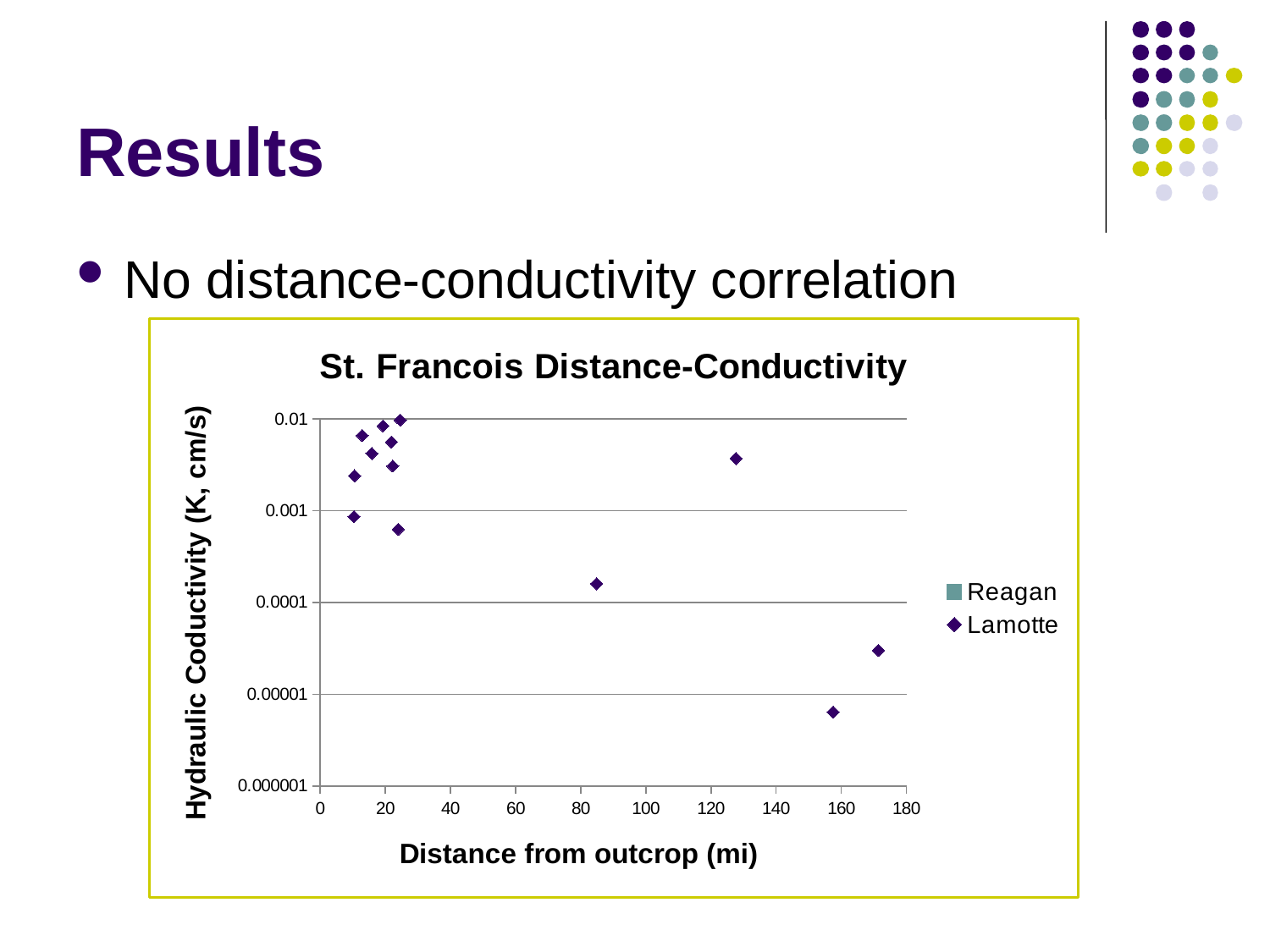
What kind of chart is shown on the slide? scatter chart Is the hydraulic conductivity of the point plotted near 85 mi greater or less than 0.001? less Is the hydraulic conductivity of the point plotted near 128 mi greater or less than 0.001? greater Is the hydraulic conductivity of the point plotted near 172 mi greater or less than 0.0001? less Which has the higher hydraulic conductivity: the point plotted near 85 mi or the point plotted near 128 mi? the point near 128 mi Does the chart show a clear rising or falling trend in conductivity with distance? no clear trend How many points are plotted at distances greater than 100 mi? 3 What is the title of the chart? St. Francois Distance-Conductivity What is the label of the x axis? Distance from outcrop (mi) How many series does the chart legend list? 2